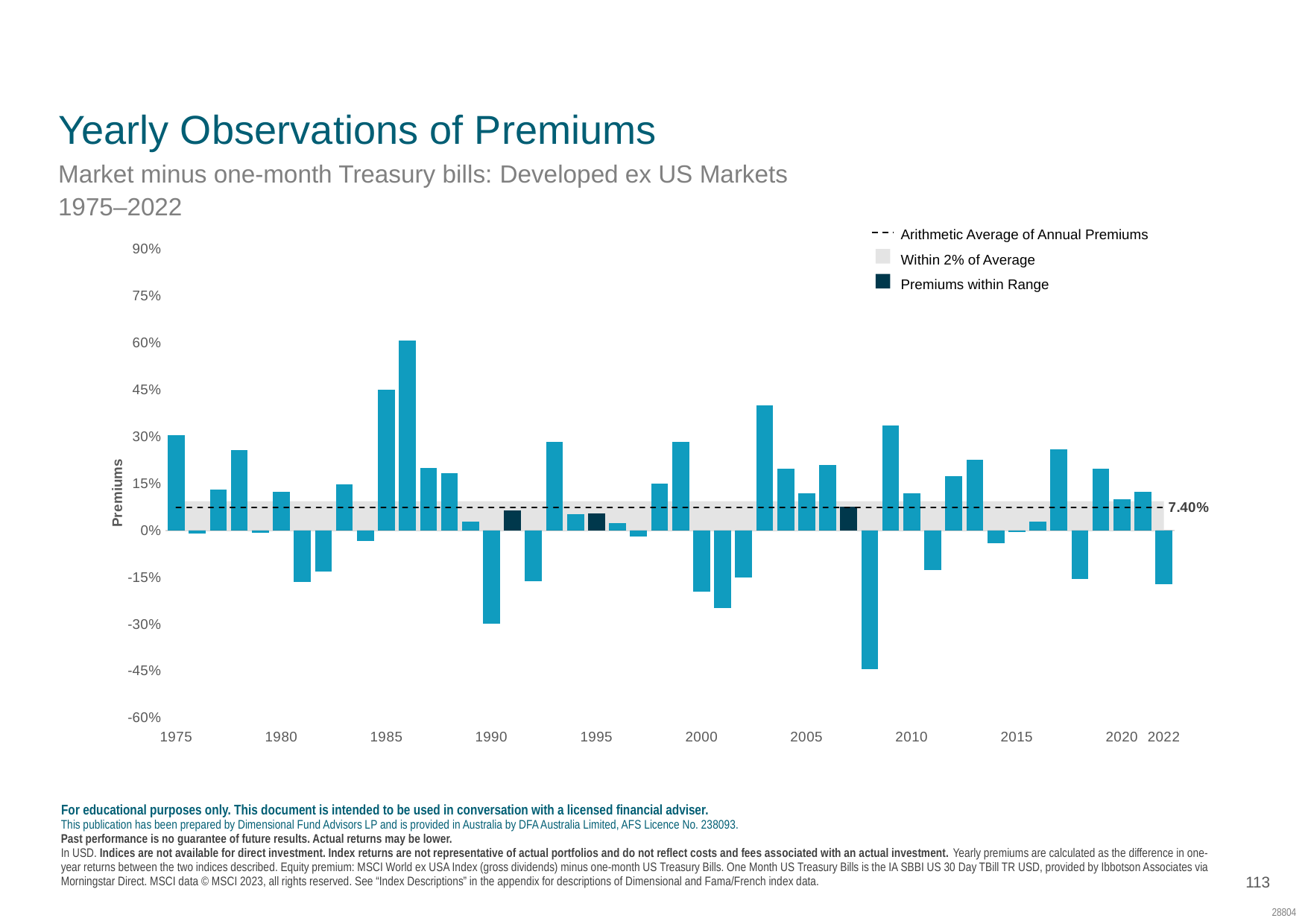
Is the premium for 1986 greater or less than 45%? greater Which year has the larger premium, 1985 or 1986? 1986 Is the premium for 2003 greater or less than 30%? greater Is the premium for 2008 greater or less than -30%? less Which year has the highest premium on the chart? 1986 How many entries does the legend list? 3 How many years does the chart cover? 48 What kind of chart is shown on the slide? bar chart Which year has the lowest premium on the chart? 2008 What is the arithmetic average of annual premiums shown on the chart? 7.40% What does the dashed horizontal line represent according to the legend? Arithmetic Average of Annual Premiums